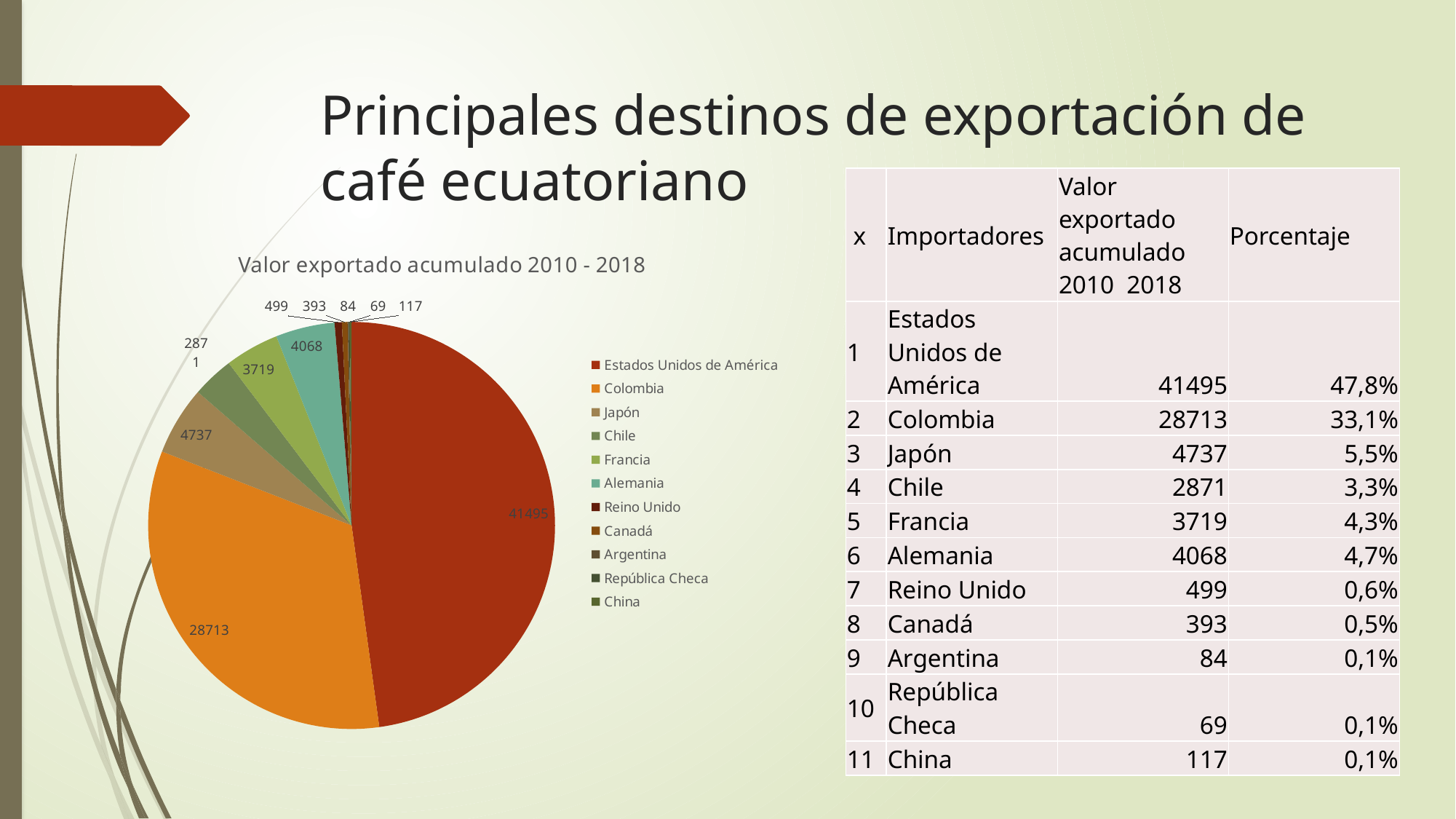
Which category has the smallest slice in the pie chart? República Checa What kind of chart is shown on the slide? pie chart What is the difference between the values for Alemania and Francia in the pie chart? 349 Which has a larger value in the pie chart, Japón or Alemania? Japón What is the value shown for Alemania in the pie chart? 4068 How many categories does the pie chart's legend list? 11 What is the value shown for Estados Unidos de América in the pie chart? 41495 Which category has the largest slice in the pie chart? Estados Unidos de América What is the difference between the values for Estados Unidos de América and Colombia in the pie chart? 12782 What is the title of the pie chart? Valor exportado acumulado 2010 - 2018 What is the value shown for Colombia in the pie chart? 28713 What is the value shown for Japón in the pie chart? 4737